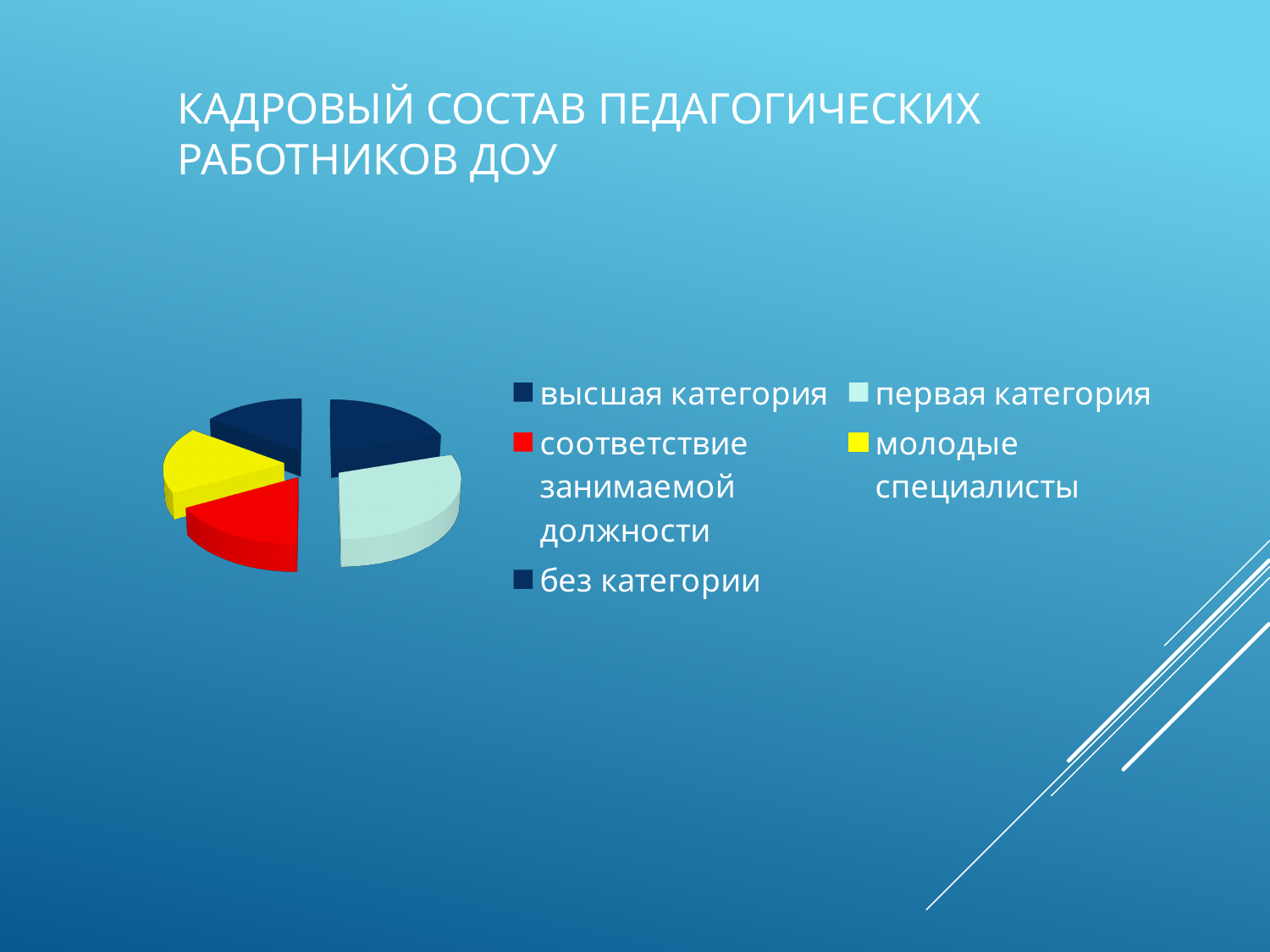
Which colour represents молодые специалисты in the pie chart? yellow What kind of chart is shown on the slide? pie chart Which slice is larger: первая категория or соответствие занимаемой должности? первая категория Which slice is larger: первая категория or молодые специалисты? первая категория Which category has the largest slice of the pie? первая категория What is the title of the slide containing the chart? КАДРОВЫЙ СОСТАВ ПЕДАГОГИЧЕСКИХ РАБОТНИКОВ ДОУ How many slices does the pie chart have? 5 How many entries does the chart legend list? 5